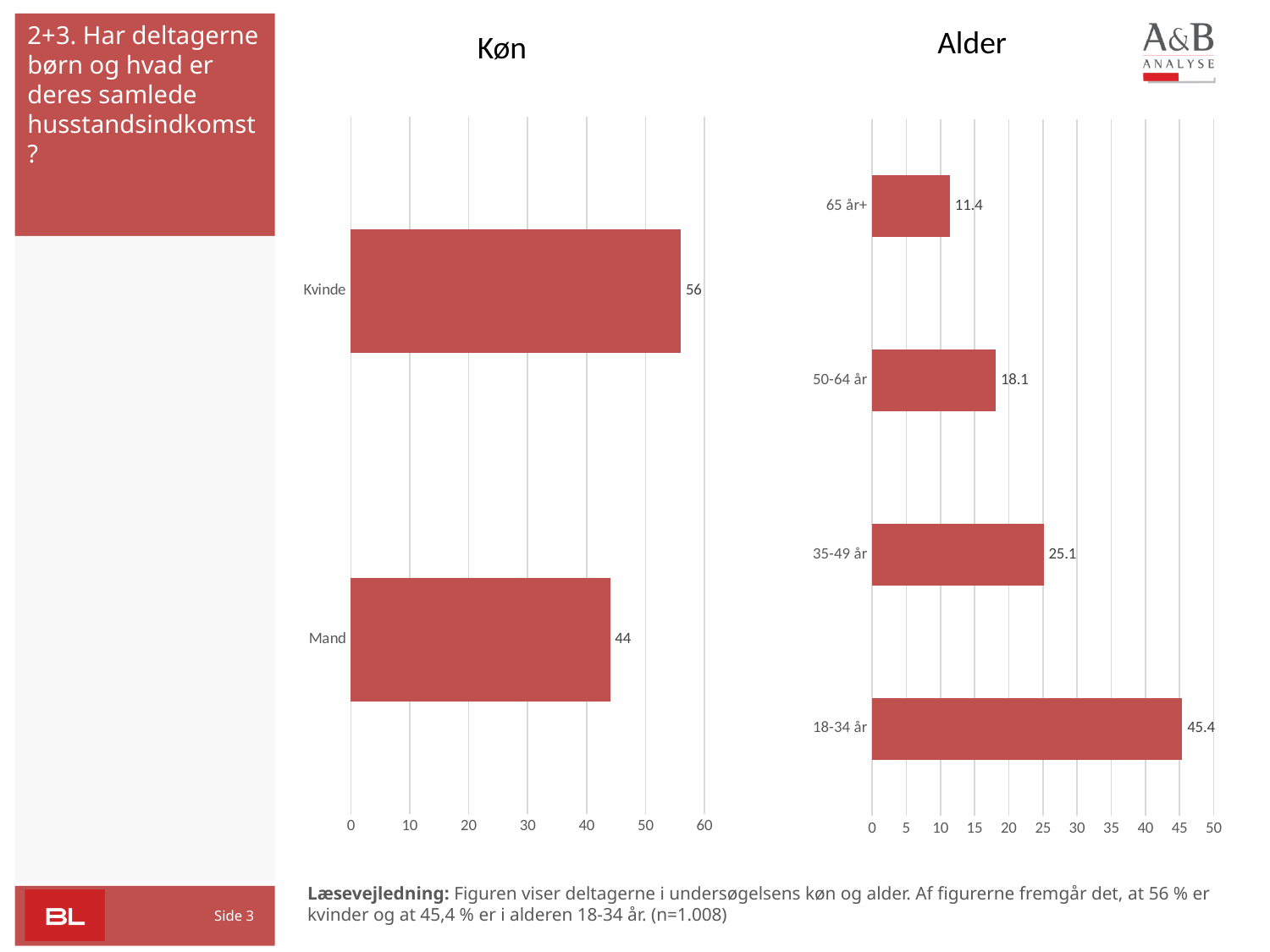
In the 'Alder' chart, which age group has the lowest value? 65 år+ What type of chart is the 'Køn' chart? Bar chart In the 'Alder' chart, what is the value for 35-49 år? 25.1 In the 'Alder' chart, what is the difference between the values for 35-49 år and 50-64 år? 7.0 In the 'Køn' chart, what is the difference between the values for Kvinde and Mand? 12 In the 'Alder' chart, which age group has the highest value? 18-34 år In the 'Alder' chart, what is the value for 65 år+? 11.4 How many age groups are shown in the 'Alder' chart? 4 In the 'Alder' chart, what is the value for 18-34 år? 45.4 In the 'Køn' chart, which category has the higher value, Kvinde or Mand? Kvinde In the 'Køn' chart, what is the value for Kvinde? 56 In the 'Køn' chart, what is the value for Mand? 44